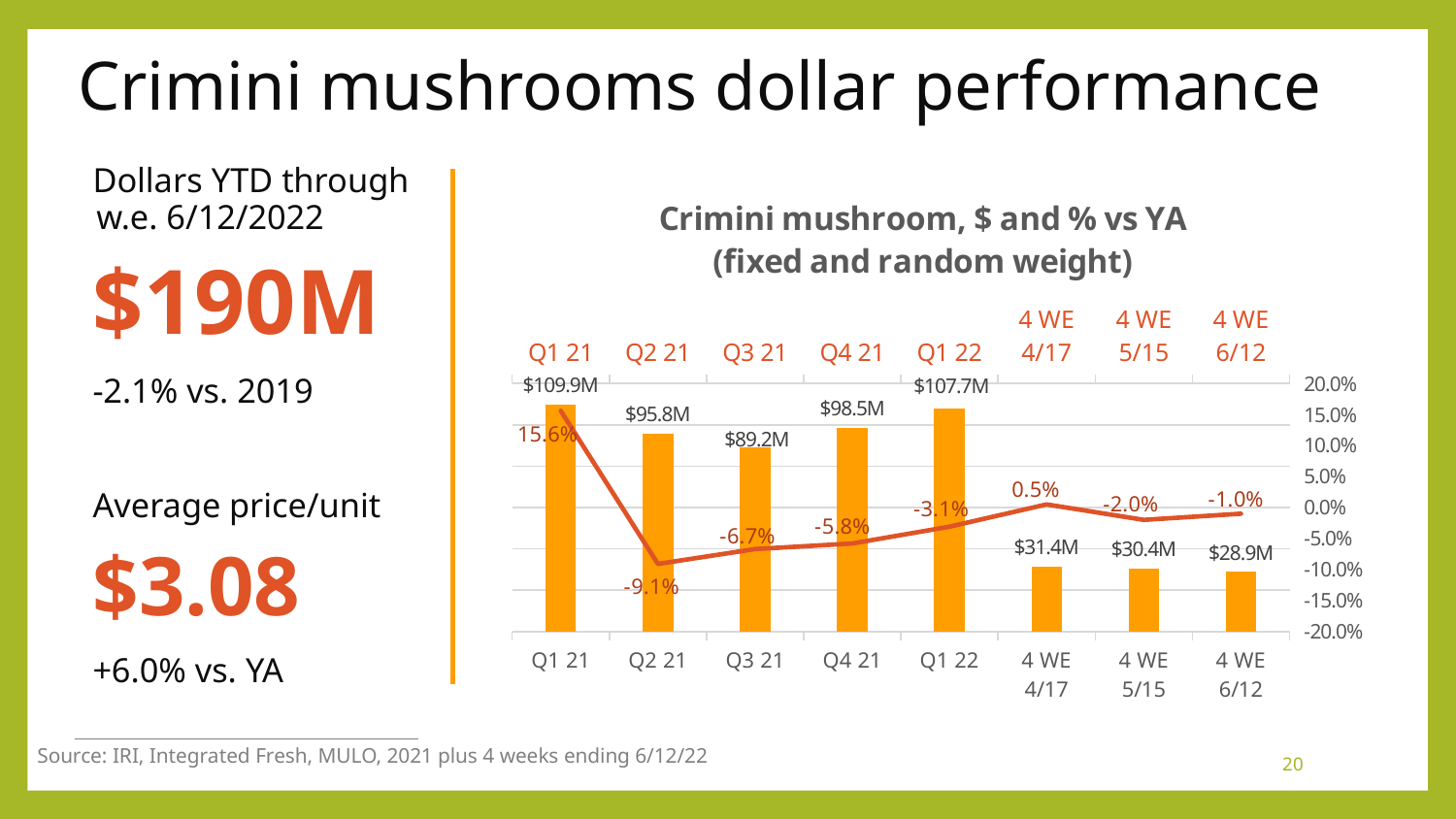
What is the title of the chart? Crimini mushroom, $ and % vs YA (fixed and random weight) What is the difference in dollar value between Q1 21 and Q2 21? $14.1M Do the dollar value bars rise or fall from Q1 21 to Q3 21? Fall How many periods are shown on the x axis of the chart? 8 Which period has the lowest % vs YA value on the line? Q2 21 What is the dollar value shown for Q1 21? $109.9M What is the % vs YA value shown for Q2 21? -9.1% What is the dollar value shown for the 4 WE 6/12 period? $28.9M Which period has the highest dollar value bar? Q1 21 What kind of chart is shown on the slide? Bar chart with a line Which has a larger dollar value, Q4 21 or Q3 21? Q4 21 What is the % vs YA value shown for the 4 WE 4/17 period? 0.5%